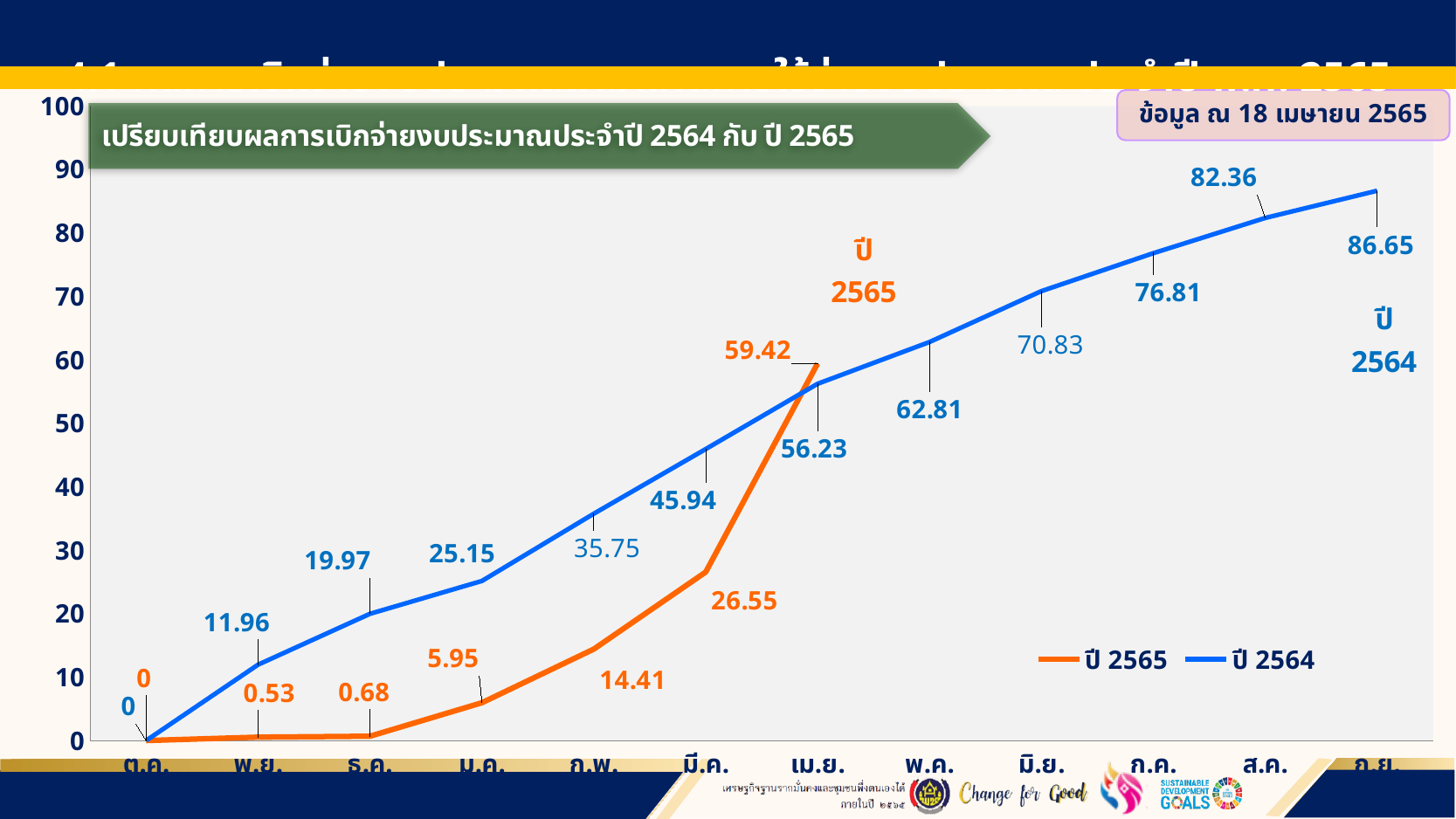
Which colour represents ปี 2565 in the chart? orange Which series has the larger value in ก.พ., ปี 2565 or ปี 2564? ปี 2564 What type of chart is shown on the slide? line chart What is the value for ปี 2564 in ก.ย.? 86.65 What is the value for ปี 2564 in ม.ค.? 25.15 What is the value for ปี 2565 in มี.ค.? 26.55 What is the difference between ปี 2565 and ปี 2564 in เม.ย.? 3.19 Does the ปี 2564 series rise or fall from ต.ค. to ก.ย.? rise What is the value for ปี 2565 in เม.ย.? 59.42 How many series does the legend list? 2 How many months are shown on the x axis? 12 In which month does the ปี 2564 series reach its highest value? ก.ย.